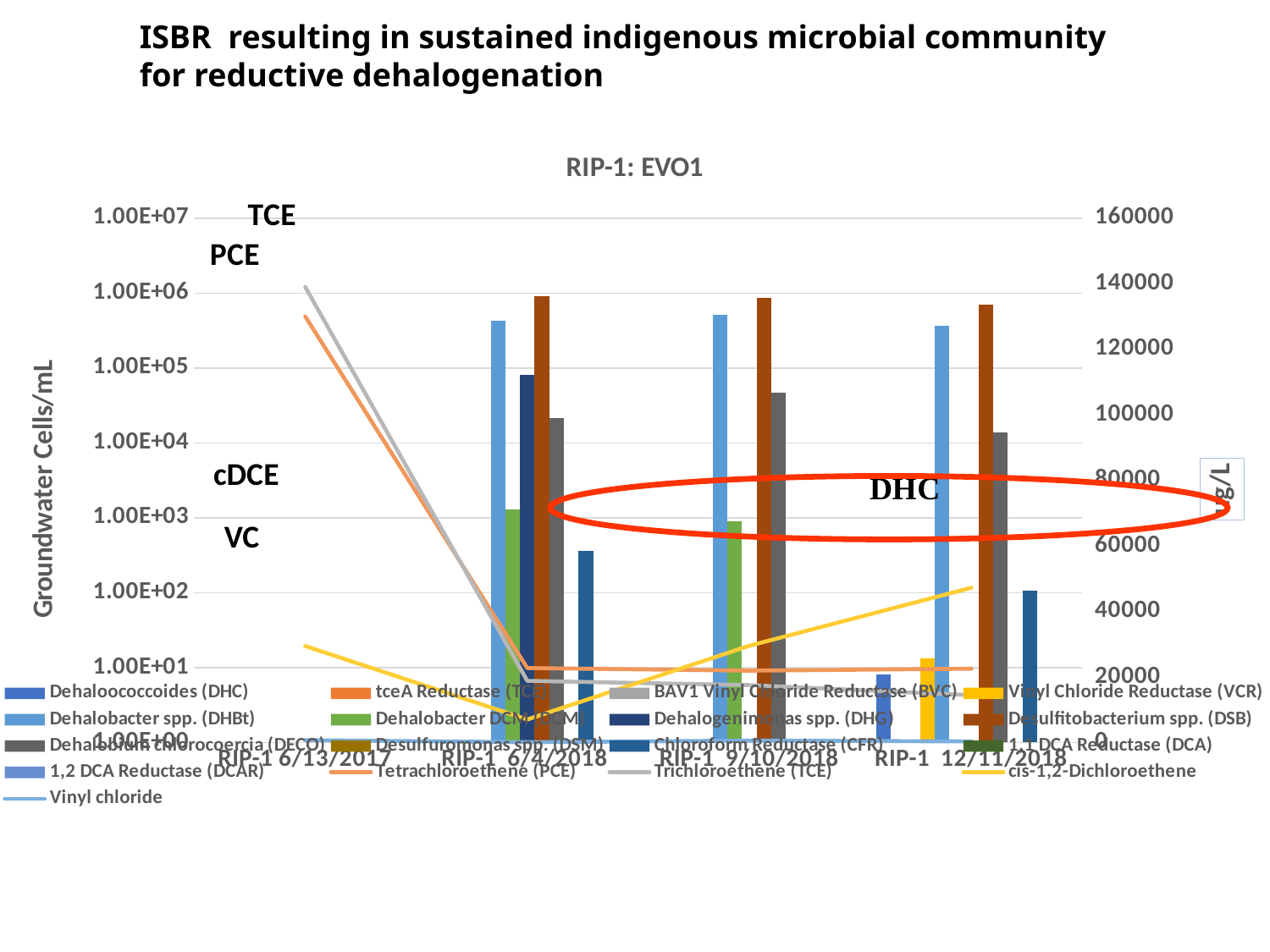
Does the cis-1,2-Dichloroethene line rise or fall from RIP-1 6/4/2018 to RIP-1 12/11/2018? rise What is the title of the chart? RIP-1: EVO1 How many series does the chart legend list? 17 What is the label of the left vertical axis? Groundwater Cells/mL Does the Trichloroethene (TCE) line rise or fall from RIP-1 6/13/2017 to RIP-1 6/4/2018? fall What kind of chart is shown on the slide? A combination bar and line chart Is the cis-1,2-Dichloroethene value at RIP-1 12/11/2018 greater or less than 60000? less How many sampling dates (x-axis categories) are shown on the chart? 4 Is the Desulfitobacterium spp. (DSB) value at RIP-1 6/4/2018 greater or less than 1.00E+05? greater Is the Trichloroethene (TCE) value at RIP-1 6/13/2017 greater or less than 120000? greater At RIP-1 6/4/2018, which is larger: the Desulfitobacterium spp. (DSB) bar or the Dehalobacter DCM (DCM) bar? Desulfitobacterium spp. (DSB)